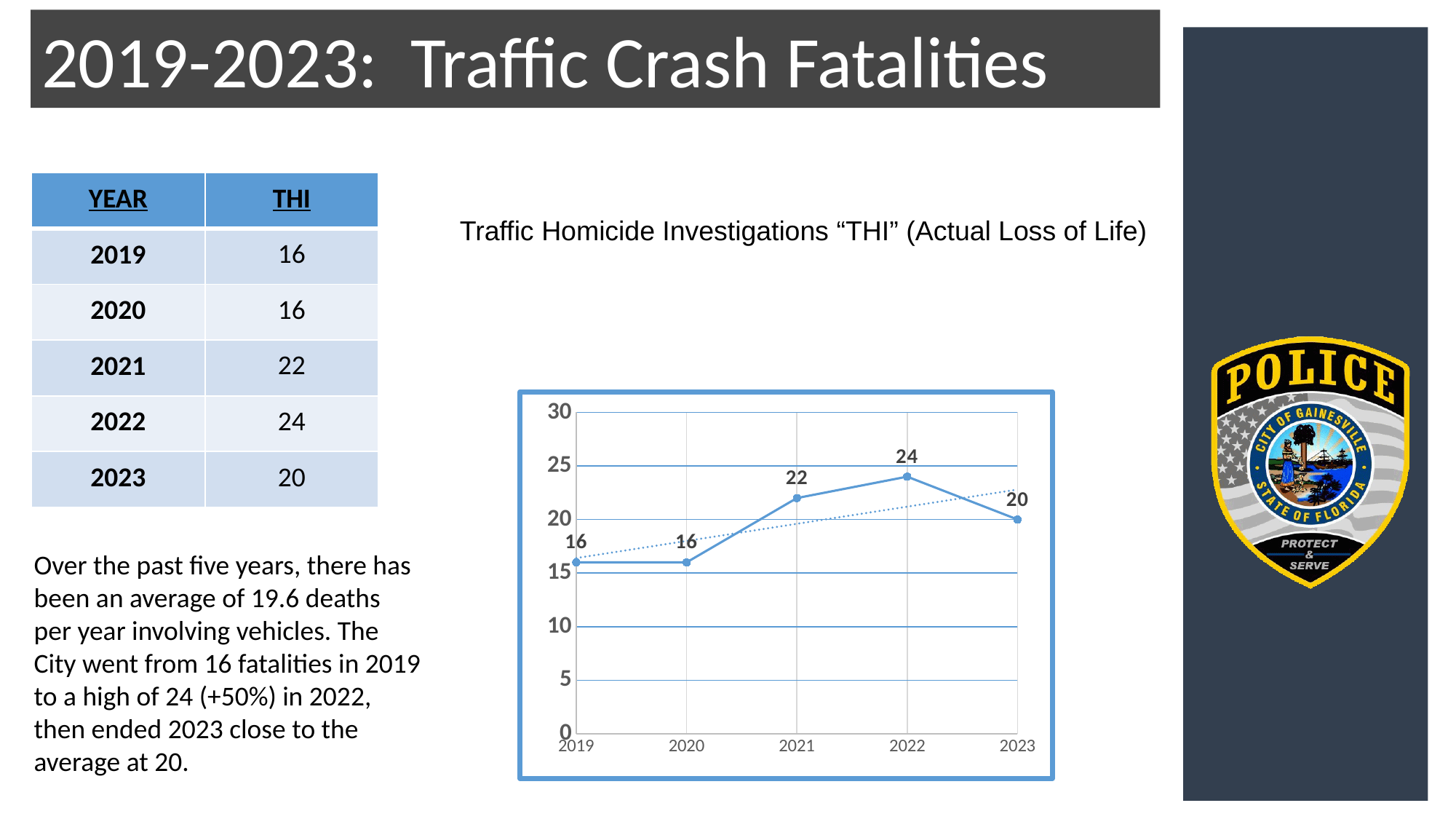
What is the value plotted for 2022? 24 What is the value plotted for 2023? 20 Is the value for 2022 greater or less than 20? greater What kind of chart is shown on the slide? line chart How many years are plotted on the chart? 5 What is the value plotted for 2021? 22 Which is larger, the value for 2021 or the value for 2023? 2021 What is the difference between the values for 2021 and 2020? 6 Does the plotted value rise or fall from 2022 to 2023? fall What is the difference between the values for 2022 and 2019? 8 Is the value for 2020 greater or less than 20? less Which year has the highest value on the chart? 2022